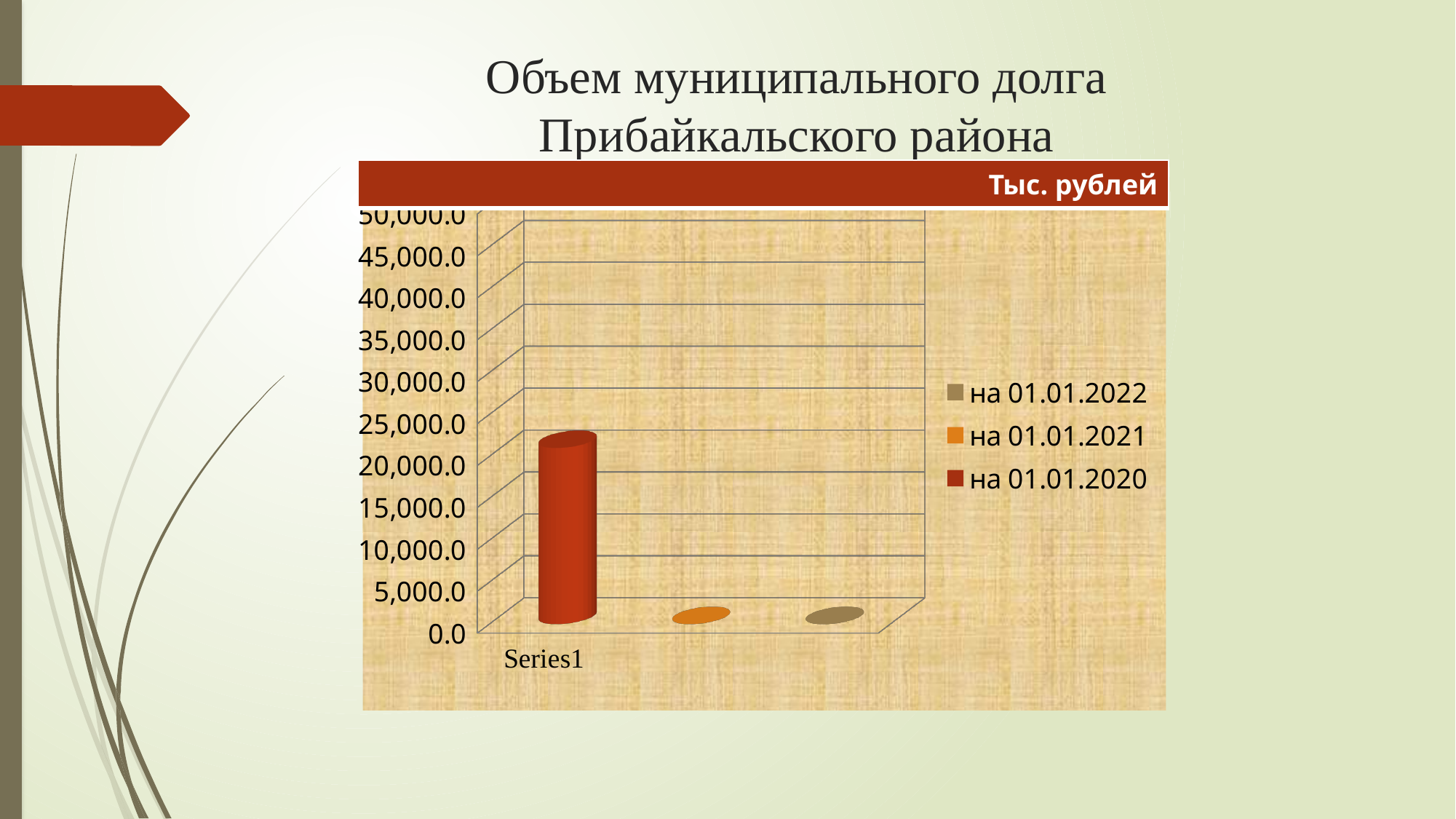
How many series does the legend list? 3 Do the values rise or fall from 01.01.2020 to 01.01.2022? fall What unit is indicated in the header bar of the chart? Тыс. рублей Is the value for на 01.01.2020 greater or less than 10,000.0? greater Which series has the highest value in the chart? на 01.01.2020 What kind of chart is shown on the slide? bar chart Which is larger, the value for на 01.01.2020 or the value for на 01.01.2022? на 01.01.2020 How many categories are shown on the x axis? 1 Is the value for на 01.01.2021 greater or less than 5,000.0? less Is the value for на 01.01.2020 greater or less than 30,000.0? less What is the category label shown on the x axis? Series1